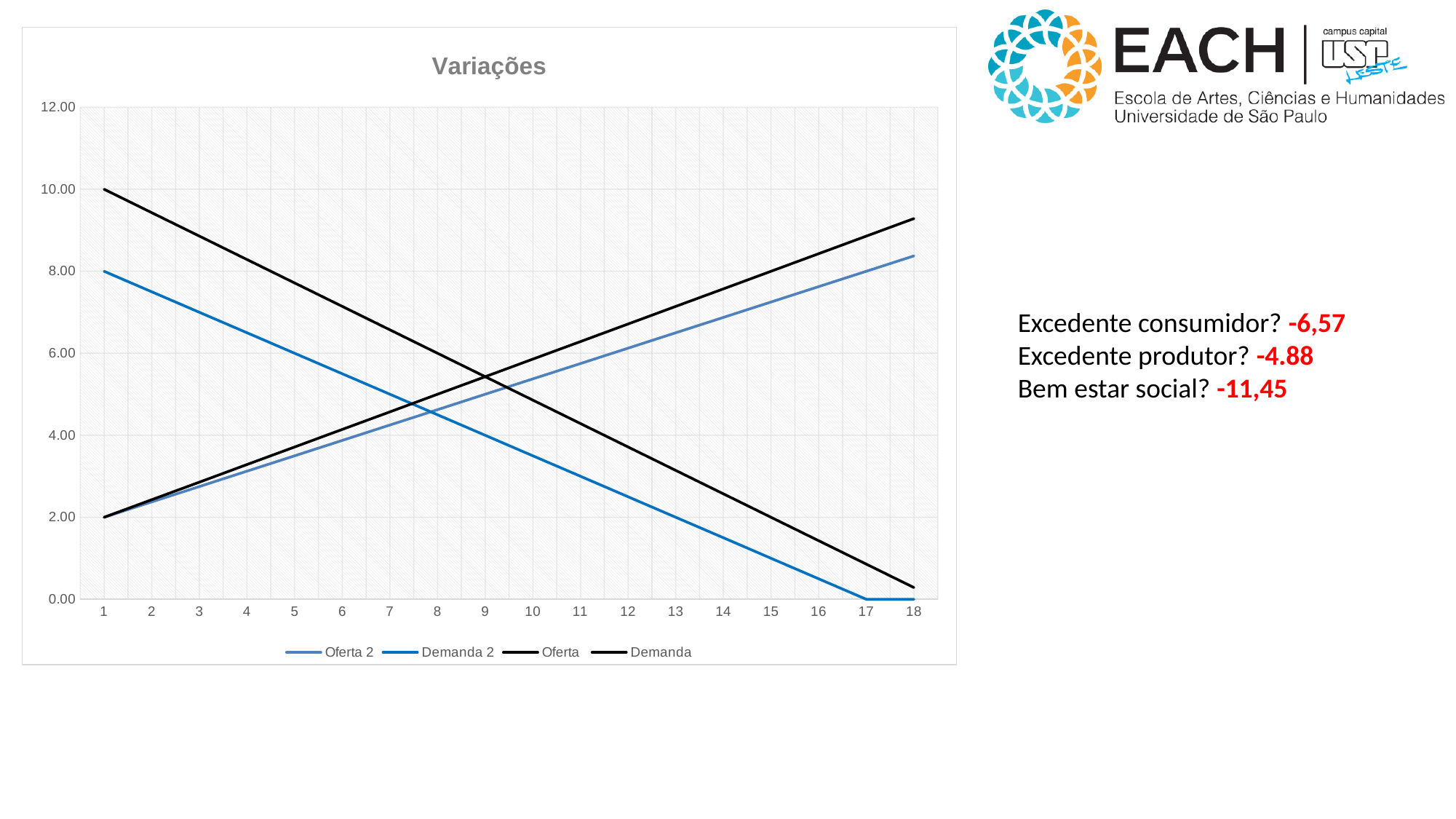
What is the value of the Demanda 2 series at x = 18? 0.00 What is the value of the Demanda series at x = 1? 10.00 What is the value of the Oferta series at x = 1? 2.00 What is the value of the Demanda 2 series at x = 1? 8.00 What is the title of the chart? Variações Does the Demanda 2 series rise or fall as x increases? falls What kind of chart is shown on the slide? line chart At x = 1, which series has the larger value, Demanda or Demanda 2? Demanda How many series does the chart legend list? 4 Does the Oferta series rise or fall as x increases? rises Is the value of the Oferta series at x = 18 greater or less than 8.00? greater How many points are on the x axis of the chart? 18